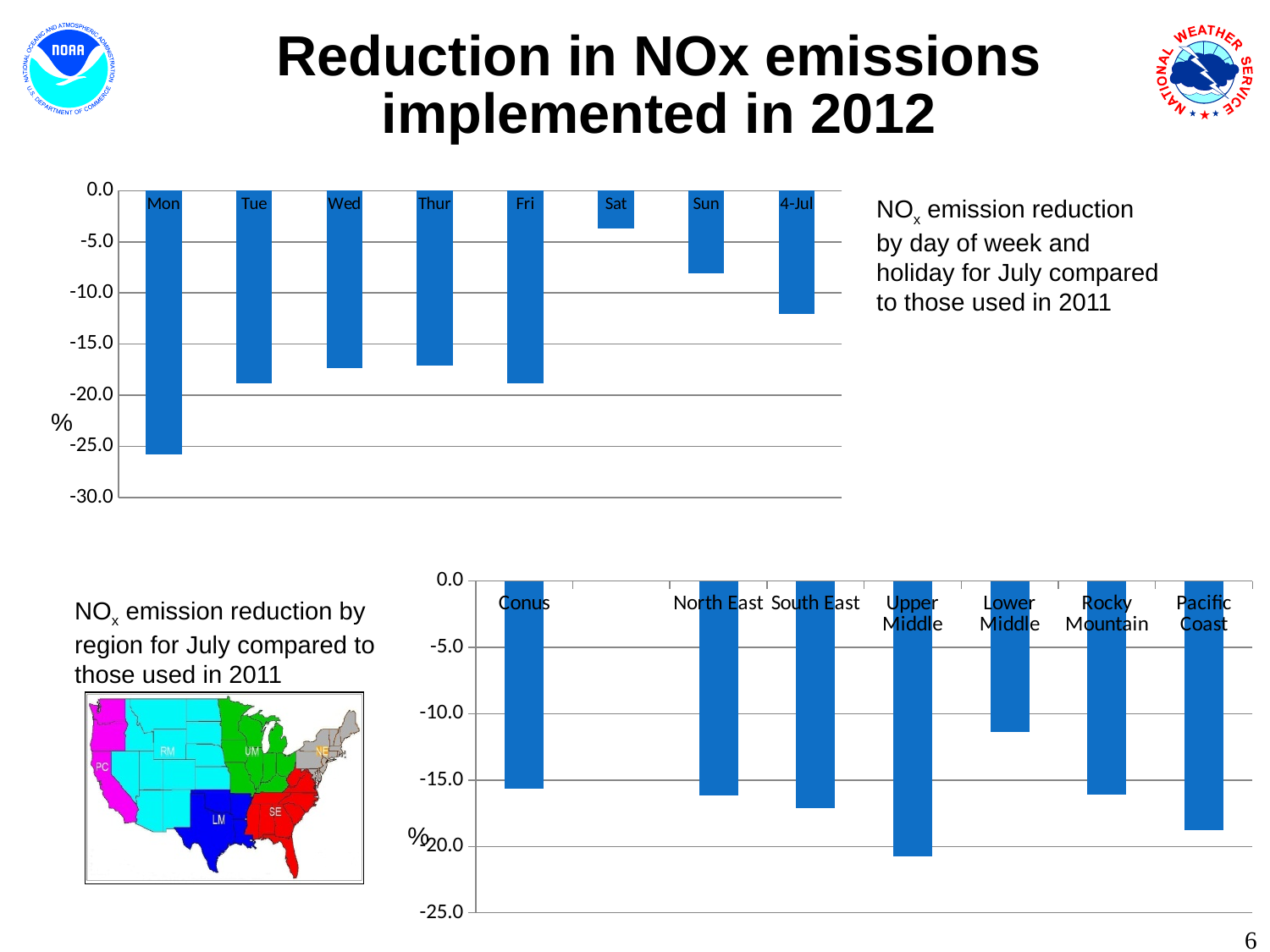
In the bottom chart (by region), is the value for Lower Middle greater or less than -15.0? greater What unit label is shown on the y axis of the bottom chart (by region)? % In the top chart (by day of week and holiday), is the value for Sun greater or less than -10.0? greater What type of chart is the top chart showing NOx emission reduction by day of week? bar chart In the bottom chart (by region), how many regions are shown on the x axis? 7 In the top chart (by day of week and holiday), which category has the lowest (most negative) value? Mon In the top chart (by day of week and holiday), which category has the highest value (closest to zero)? Sat In the top chart (by day of week and holiday), which bar extends further below zero, Tue or Sun? Tue In the top chart (by day of week and holiday), is the value for Mon greater or less than -20.0? less In the top chart (by day of week and holiday), how many categories are shown on the x axis? 8 In the bottom chart (by region), which region has the lowest (most negative) value? Upper Middle